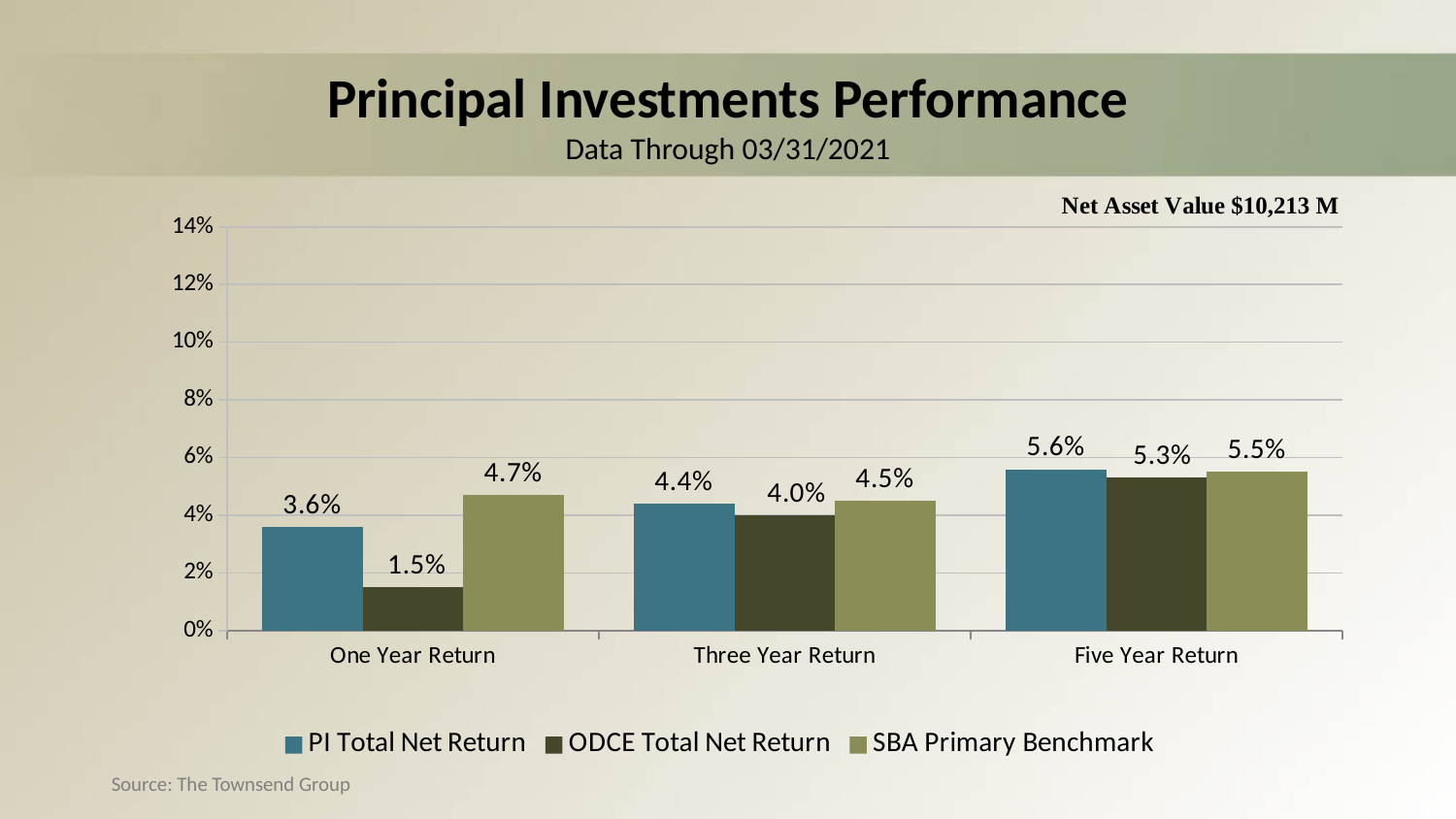
What is the PI Total Net Return for One Year Return? 3.6% What kind of chart is shown on the slide? bar chart How many series does the legend list? 3 How many return periods are shown on the x axis? 3 What Net Asset Value is stated on the chart? $10,213 M Which period has the lowest ODCE Total Net Return? One Year Return What is the SBA Primary Benchmark value for Five Year Return? 5.5% Which period has the highest PI Total Net Return? Five Year Return What is the difference between the SBA Primary Benchmark and the PI Total Net Return for One Year Return? 1.1% Is the ODCE Total Net Return for One Year Return greater or less than 2%? less For Three Year Return, which is larger: PI Total Net Return or ODCE Total Net Return? PI Total Net Return What is the ODCE Total Net Return for Three Year Return? 4.0%